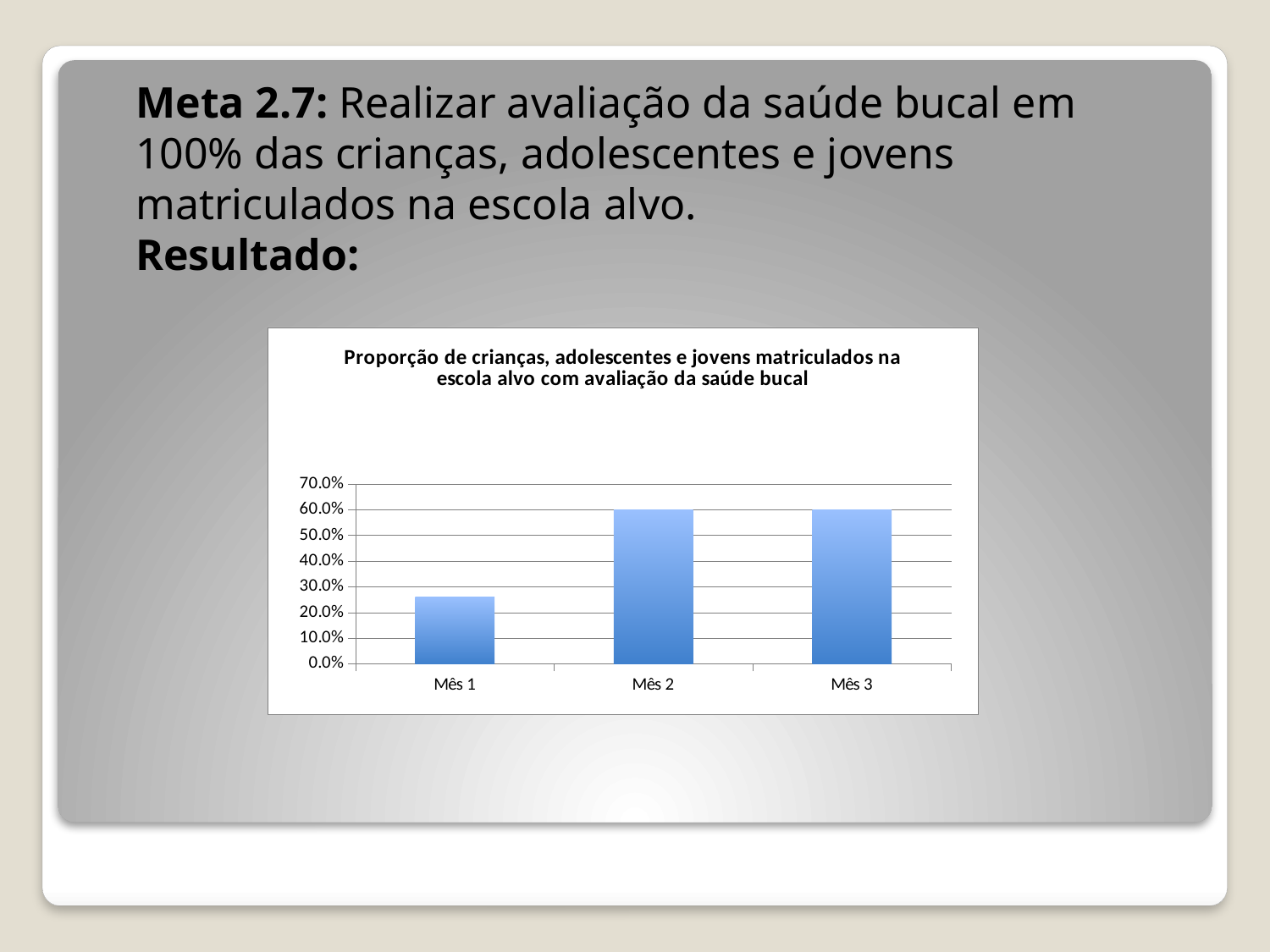
Is the value for Mês 1 greater or less than 20.0%? greater Is the value for Mês 1 greater or less than 30.0%? less How many categories are shown on the x axis of the chart? 3 What is the value for Mês 2 in the chart? 60.0% What kind of chart is shown on the slide? bar chart Does the value rise or fall from Mês 1 to Mês 2? rise What is the highest value shown on the y axis of the chart? 70.0% Which month has the lowest value in the chart? Mês 1 What is the title of the chart? Proporção de crianças, adolescentes e jovens matriculados na escola alvo com avaliação da saúde bucal Is the value for Mês 2 greater or less than 50.0%? greater Which is larger, the value for Mês 1 or the value for Mês 2? Mês 2